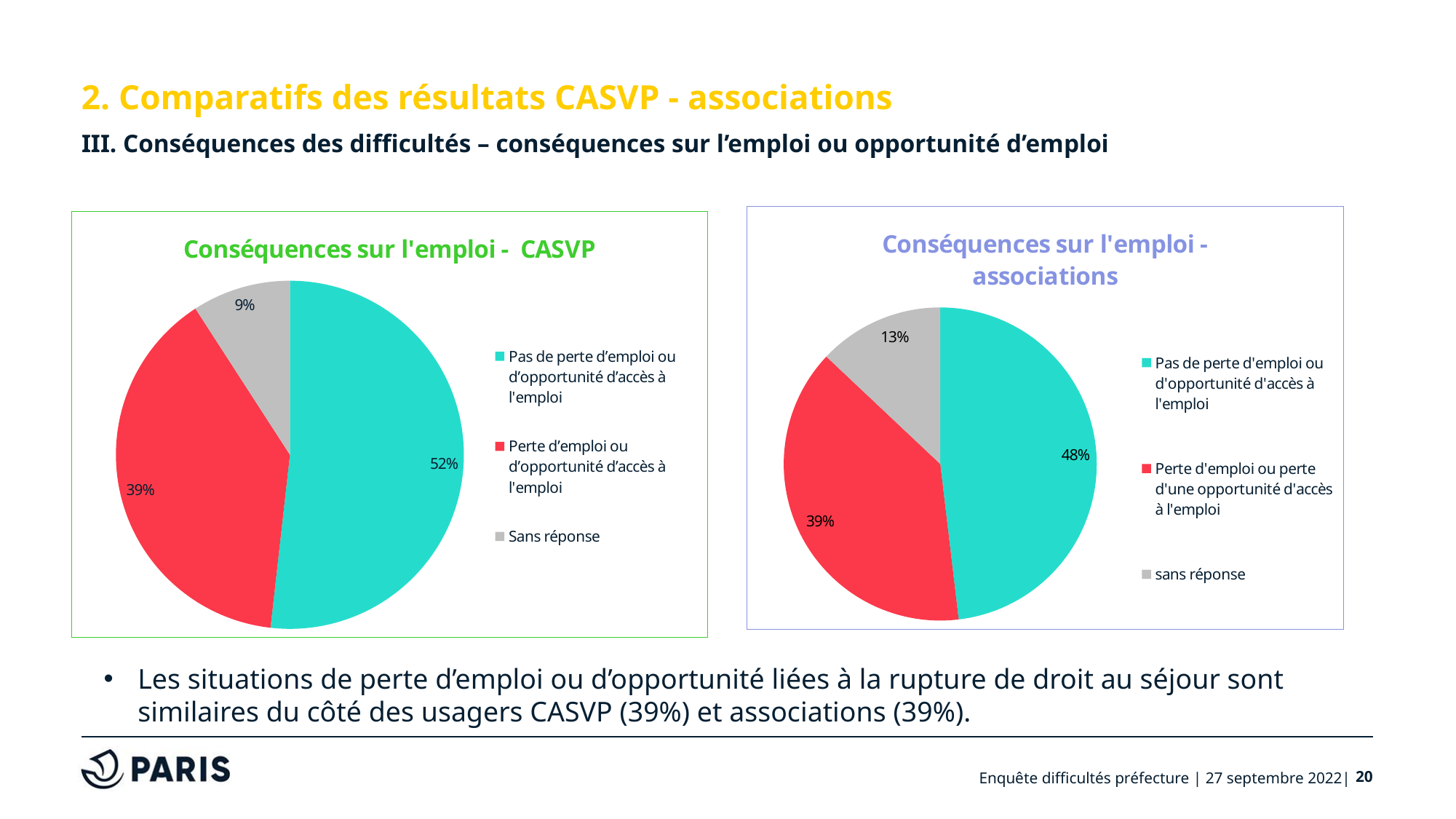
In the 'Conséquences sur l'emploi - CASVP' chart, what colour is the 'Sans réponse' slice? Grey In the 'Conséquences sur l'emploi - CASVP' chart, which category has the largest slice? Pas de perte d'emploi ou d'opportunité d'accès à l'emploi In the 'Conséquences sur l'emploi - CASVP' chart, what share is labelled for 'Pas de perte d'emploi ou d'opportunité d'accès à l'emploi'? 52% What is the difference between the 'Sans réponse' share in the associations chart and the 'Sans réponse' share in the CASVP chart? 4% In the 'Conséquences sur l'emploi - CASVP' chart, what share is labelled for 'Sans réponse'? 9% In the 'Conséquences sur l'emploi - associations' chart, what share is labelled for 'Pas de perte d'emploi ou d'opportunité d'accès à l'emploi'? 48% In the 'Conséquences sur l'emploi - associations' chart, what share is labelled for 'sans réponse'? 13% Which is larger: the 'Pas de perte d'emploi' share in the CASVP chart or in the associations chart? CASVP In the 'Conséquences sur l'emploi - associations' chart, what share is labelled for 'Perte d'emploi ou perte d'une opportunité d'accès à l'emploi'? 39% How many categories does the legend of the 'Conséquences sur l'emploi - associations' chart list? 3 What type of chart is 'Conséquences sur l'emploi - CASVP'? Pie chart In the 'Conséquences sur l'emploi - associations' chart, which category has the smallest slice? sans réponse